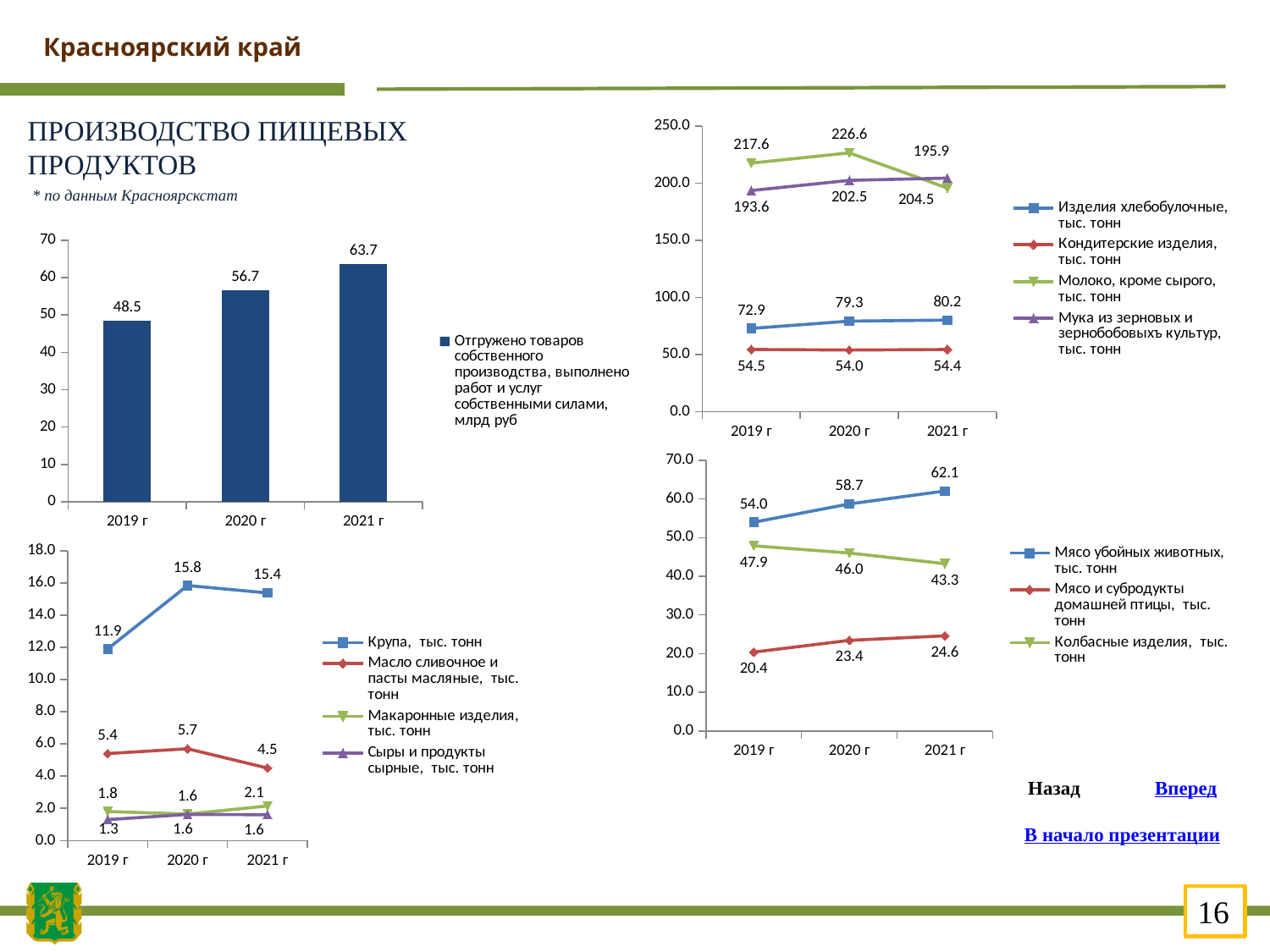
In the top-left bar chart, by how much did the value increase from 2019 г to 2021 г? 15.2 In the top-right line chart, which series has the highest value in 2020 г? Молоко, кроме сырого, тыс. тонн In the bottom-right line chart, what is the value of Мясо и субродукты домашней птицы in 2019 г? 20.4 In the top-right line chart, what is the difference between Молоко, кроме сырого and Мука из зерновых и зернобобовых культур in 2019 г? 24.0 In the bottom-left line chart, what is the value of Масло сливочное и пасты масляные in 2021 г? 4.5 In the top-left bar chart, do the values rise or fall from 2019 г to 2021 г? rise In the top-right line chart, what is the value of Изделия хлебобулочные in 2021 г? 80.2 In the top-left bar chart, what is the value for 2021 г? 63.7 How many series does the legend of the bottom-left line chart list? 4 In the bottom-right line chart, which is larger in 2021 г: Мясо убойных животных or Колбасные изделия? Мясо убойных животных In the bottom-left line chart, what is the value of Крупа, тыс. тонн in 2020 г? 15.8 What kind of chart is the top-left chart showing shipped goods of own production (млрд руб)? bar chart